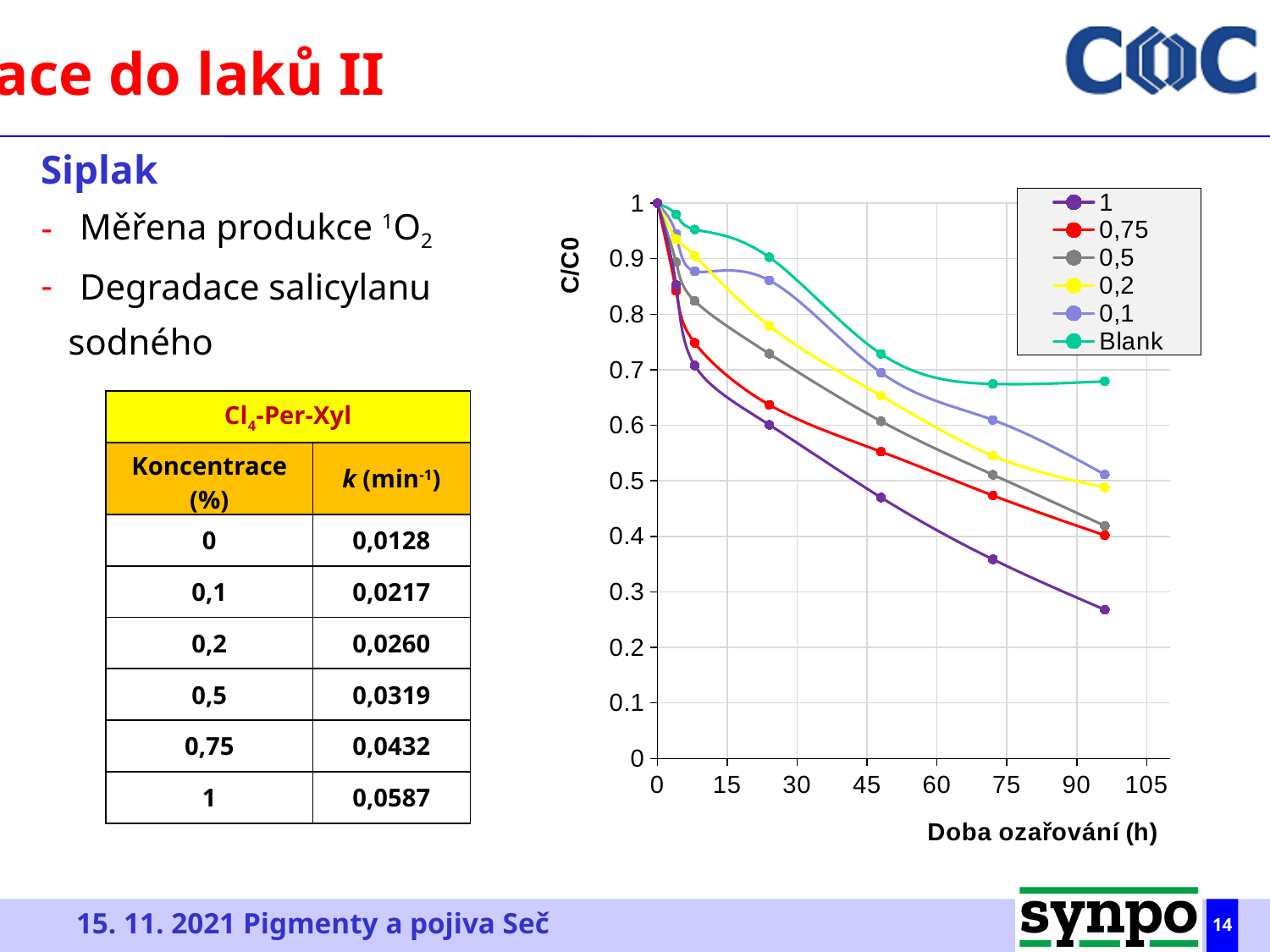
Which series has the lowest C/C0 value at 96 h? 1 What is the label of the y axis of the chart? C/C0 At 96 h, which series has the larger C/C0 value: 'Blank' or '1'? Blank Is the C/C0 value of the series '1' at 72 h greater or less than 0.4? less Which series has the highest C/C0 value at 96 h? Blank What is the label of the x axis of the chart? Doba ozařování (h) At 48 h, which series has the larger C/C0 value: '0,5' or '0,75'? 0,5 What kind of chart is shown on the slide? line chart Do the C/C0 values of the series '1' rise or fall as irradiation time increases? fall Is the C/C0 value of the series '0,2' at 24 h greater or less than 0.7? greater Is the C/C0 value of the 'Blank' series at 96 h greater or less than 0.6? greater How many series does the chart legend list? 6